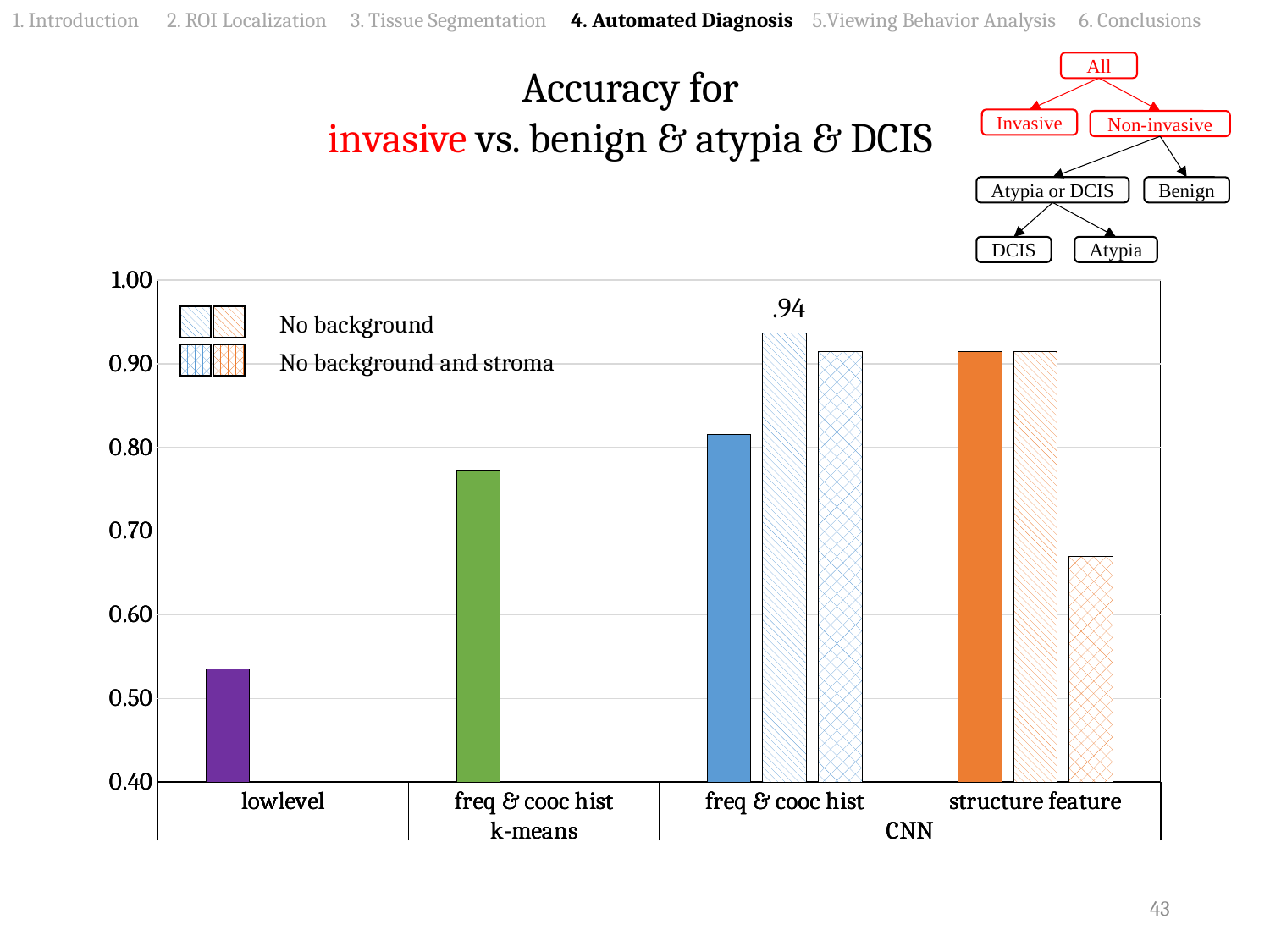
Is the 'No background and stroma' bar for structure feature greater or less than 0.70? less How many entries does the chart legend list? 2 How many category groups are shown along the x axis? 4 What value is printed as a data label on the tallest bar in the chart? .94 What type of chart is shown on the slide? bar chart Which category contains the tallest bar in the chart? freq & cooc hist (CNN) What is the lowest value shown on the y axis? 0.40 Is the value for freq & cooc hist under k-means greater or less than 0.70? greater What is the title of the chart? Accuracy for invasive vs. benign & atypia & DCIS Which category has the lowest bar in the chart? lowlevel Is the value for lowlevel greater or less than 0.60? less Which is larger: the bar for lowlevel or the bar for freq & cooc hist under k-means? freq & cooc hist under k-means